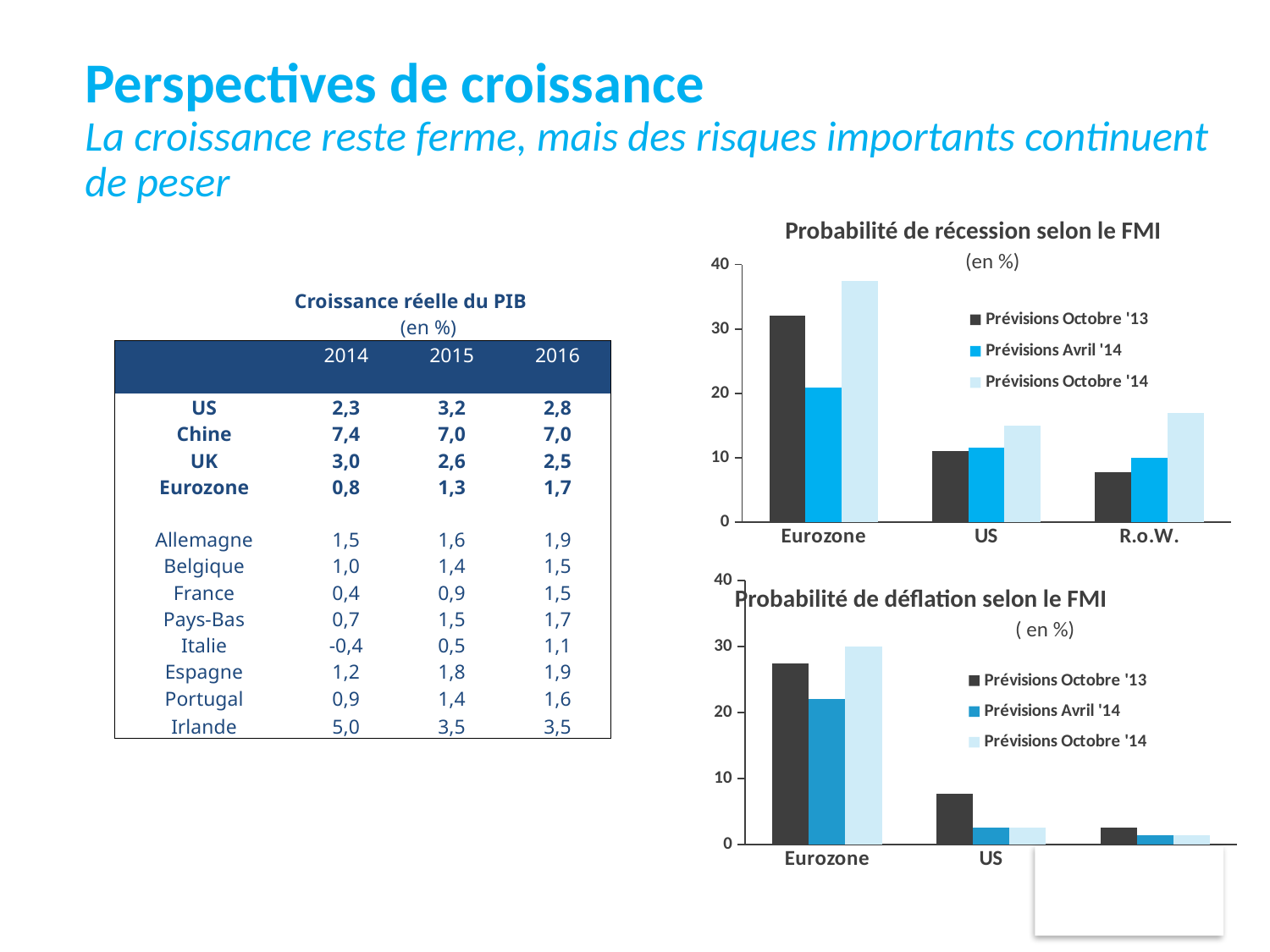
What kind of chart is 'Probabilité de déflation selon le FMI'? Bar chart In the 'Probabilité de récession selon le FMI' chart, is the value for US under Prévisions Octobre '14 greater or less than 20? less In the 'Probabilité de récession selon le FMI' chart, is the value for Eurozone under Prévisions Octobre '13 greater or less than 20? greater In the 'Probabilité de déflation selon le FMI' chart, which category has the highest value for Prévisions Octobre '14? Eurozone In the 'Probabilité de déflation selon le FMI' chart, is the value for US under Prévisions Octobre '13 greater or less than 10? less In the 'Probabilité de récession selon le FMI' chart, how many series does the legend list? 3 What kind of chart is 'Probabilité de récession selon le FMI'? Bar chart In the 'Probabilité de récession selon le FMI' chart, do the Prévisions Octobre '13 values rise or fall from Eurozone to R.o.W.? fall In the 'Probabilité de récession selon le FMI' chart, for Eurozone, which is larger: Prévisions Octobre '13 or Prévisions Avril '14? Prévisions Octobre '13 In the 'Probabilité de récession selon le FMI' chart, which category has the highest value for Prévisions Octobre '14? Eurozone In the 'Probabilité de récession selon le FMI' chart, how many categories are shown on the x axis? 3 In the 'Probabilité de déflation selon le FMI' chart, what are the three legend entries? Prévisions Octobre '13, Prévisions Avril '14, Prévisions Octobre '14